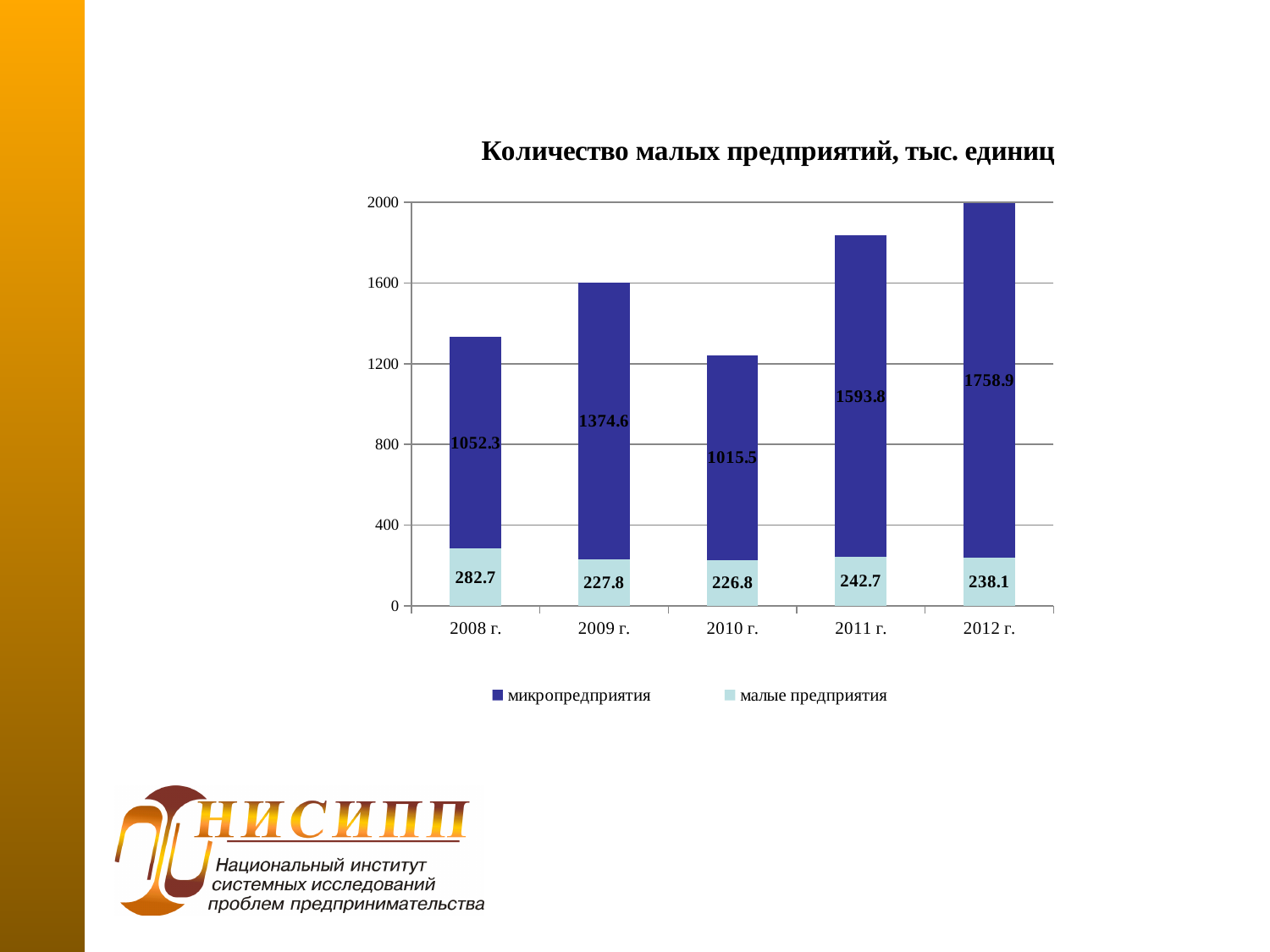
How many series does the legend list? 2 What is the total height of the stacked bar for 2009 г.? 1602.4 In which year is the value for малые предприятия the lowest? 2010 г. What is the value for микропредприятия in 2010 г.? 1015.5 What is the value for микропредприятия in 2012 г.? 1758.9 What is the title of the chart? Количество малых предприятий, тыс. единиц What is the value for малые предприятия in 2008 г.? 282.7 What is the difference between the микропредприятия values for 2011 г. and 2010 г.? 578.3 Which is larger: the малые предприятия value for 2011 г. or for 2012 г.? 2011 г. In which year is the value for микропредприятия the highest? 2012 г. What kind of chart is shown on the slide? Stacked bar chart How many years are shown on the x axis? 5